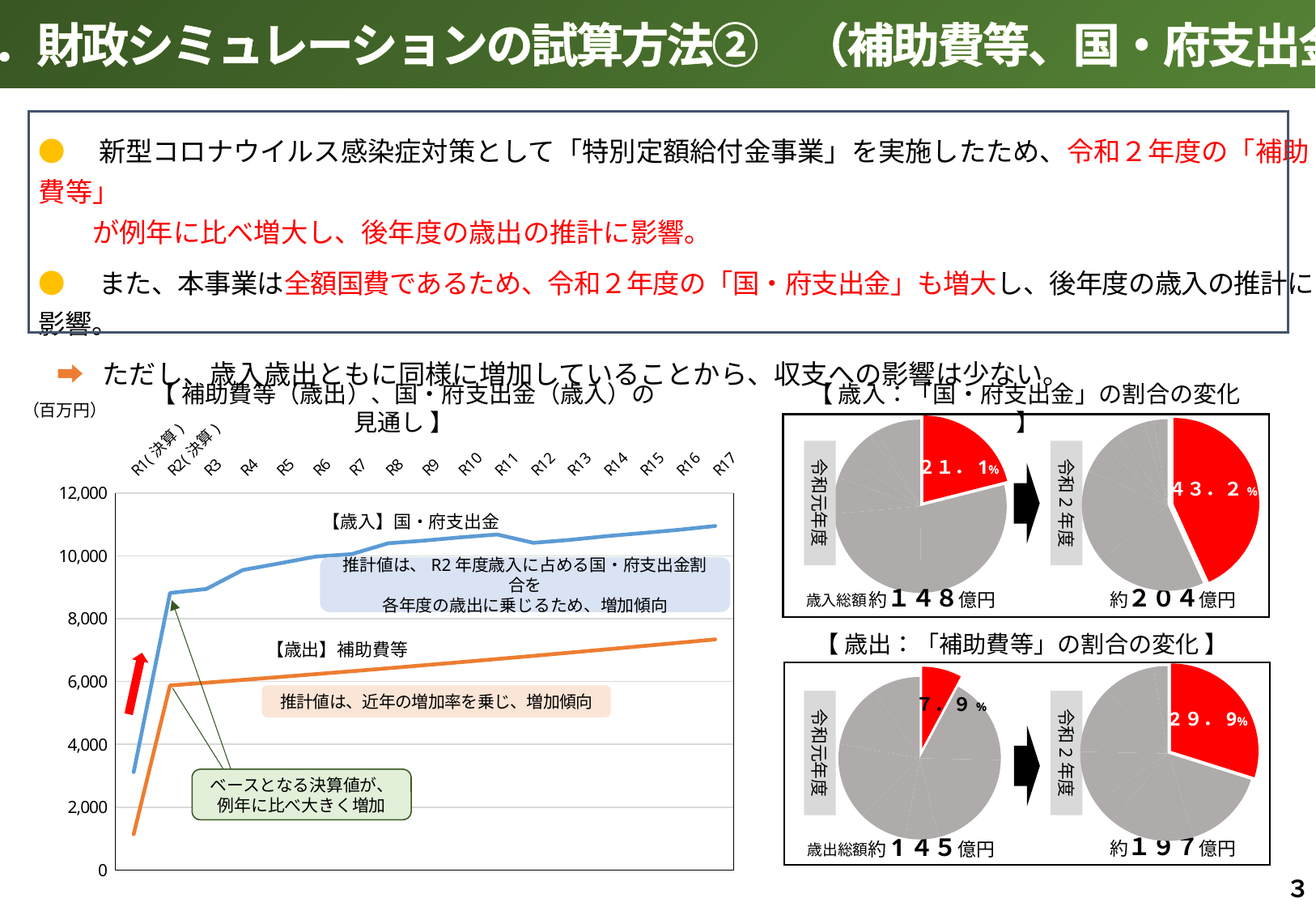
In the 【歳入：「国・府支出金」の割合の変化】 pie charts, what share does 国・府支出金 have in 令和元年度? 21.1% In the left line chart, which series is higher at R10: 【歳入】国・府支出金 or 【歳出】補助費等? 【歳入】国・府支出金 What kind of chart is the left chart titled 【補助費等（歳出）、国・府支出金（歳入）の見通し】? line chart In the 【歳入：「国・府支出金」の割合の変化】 pie charts, what is the 歳入総額 shown for 令和元年度? 約148億円 In the left line chart, is the value of 【歳出】補助費等 at R1(決算) greater or less than 2,000? less In the 【歳出：「補助費等」の割合の変化】 pie charts, what share does 補助費等 have in 令和元年度? 7.9% In the left line chart, does the 【歳入】国・府支出金 line rise or fall from R2(決算) to R17? rise In the 【歳出：「補助費等」の割合の変化】 pie charts, by how many percentage points does the 補助費等 share in 令和2年度 (29.9%) exceed that in 令和元年度 (7.9%)? 22.0 percentage points In the left line chart, how many fiscal-year categories are shown on the x axis (R1(決算) through R17)? 17 In the left line chart, is the value of 【歳入】国・府支出金 at R17 greater or less than 10,000? greater In the left line chart, how many series are plotted? 2 In the 【歳入：「国・府支出金」の割合の変化】 pie charts, what share does 国・府支出金 have in 令和2年度? 43.2%